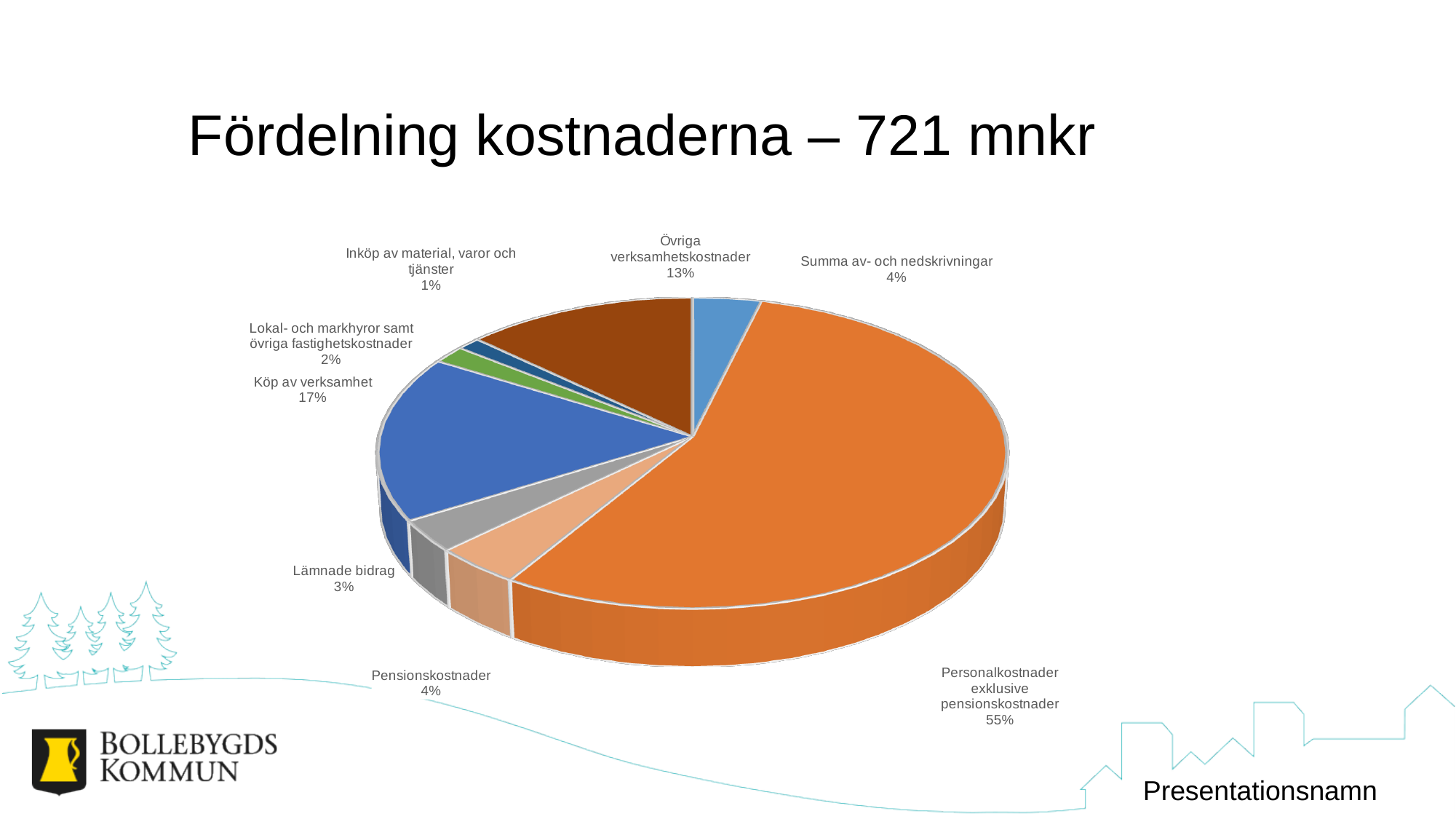
What share of the costs is Köp av verksamhet? 17% What kind of chart is shown on the slide? Pie chart What share of the costs is Lämnade bidrag? 3% How many categories (slices) does the pie chart have? 8 What share of the costs is Inköp av material, varor och tjänster? 1% Which is larger, the share for Lokal- och markhyror samt övriga fastighetskostnader or the share for Pensionskostnader? Pensionskostnader Which category has the smallest share of the pie? Inköp av material, varor och tjänster Which category has the largest share of the pie? Personalkostnader exklusive pensionskostnader What is the title of the chart slide? Fördelning kostnaderna – 721 mnkr What is the difference in percentage points between Köp av verksamhet and Övriga verksamhetskostnader? 4 percentage points